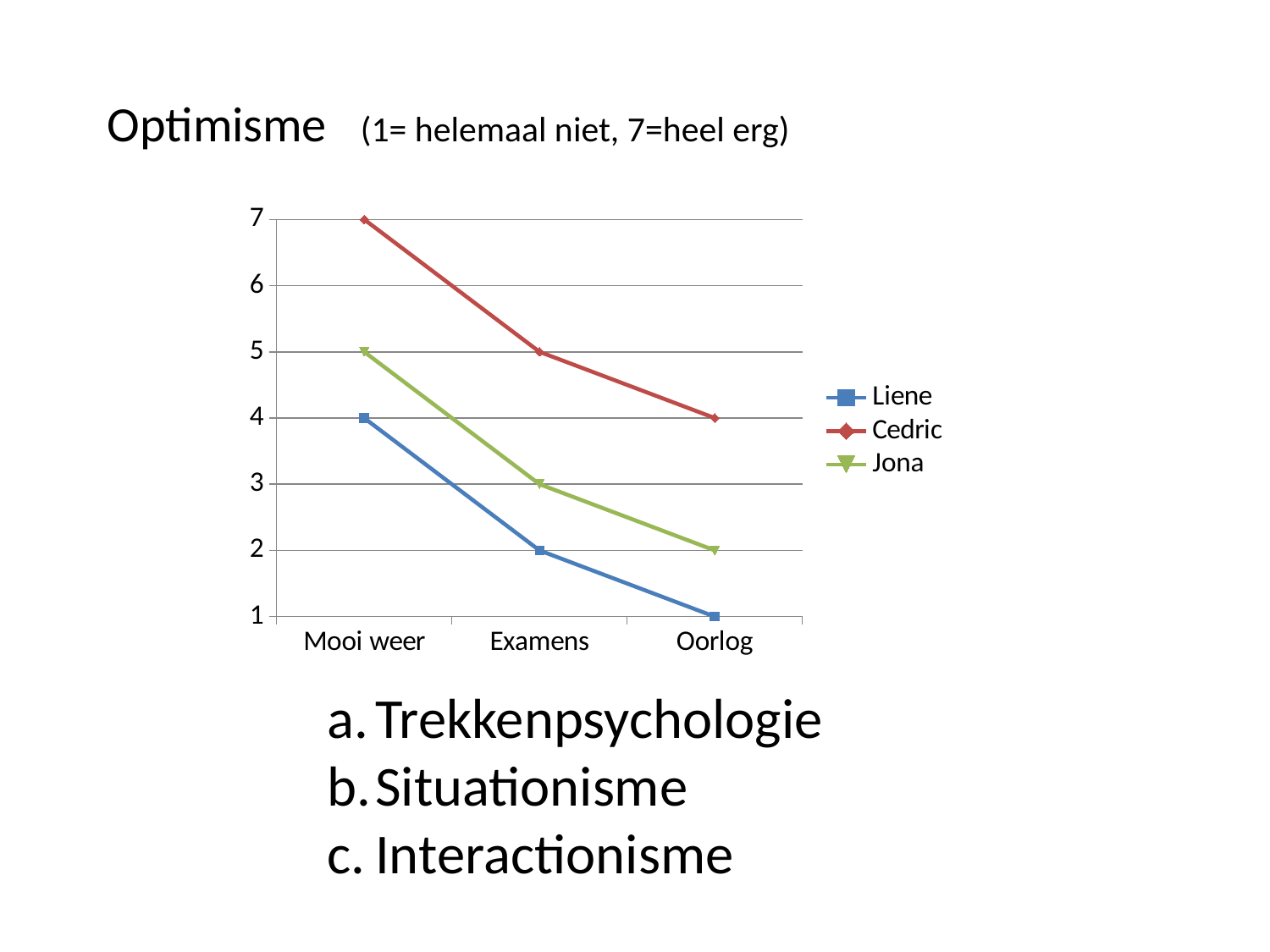
How many categories are shown on the x axis? 3 Do the values for Liene rise or fall from Mooi weer to Oorlog? fall What is the title of the chart? Optimisme Which is larger: Jona's value at Mooi weer or Cedric's value at Oorlog? Jona's value at Mooi weer What type of chart is shown on the slide? line chart How many series does the legend list? 3 What is the difference between Cedric's and Liene's values at Oorlog? 3 What is the value for Cedric at Mooi weer? 7 What is the value for Liene at Oorlog? 1 What is the value for Jona at Examens? 3 Which series has the highest value at Examens? Cedric Which series has the lowest value at Mooi weer? Liene